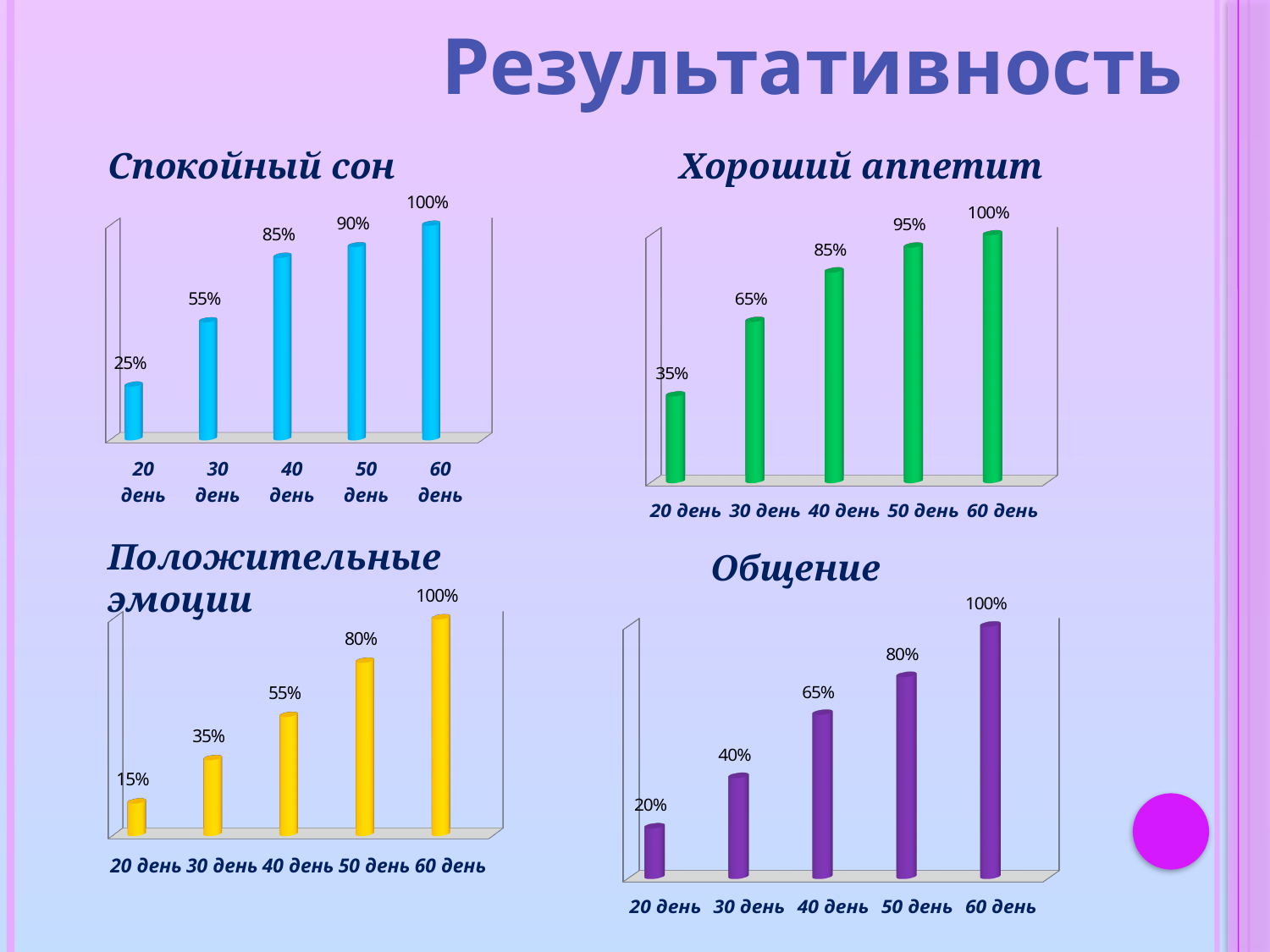
What kind of chart is the 'Положительные эмоции' chart? Bar chart In the 'Хороший аппетит' chart, what is the difference between the values for 60 день and 40 день? 15% In the 'Положительные эмоции' chart, which category has the lowest value? 20 день How many categories are shown in the 'Хороший аппетит' chart? 5 In the 'Спокойный сон' chart, do the values rise or fall from 20 день to 60 день? Rise In the 'Общение' chart, what is the value for 30 день? 40% In the 'Спокойный сон' chart, what is the difference between the values for 30 день and 20 день? 30% In the 'Положительные эмоции' chart, what is the value for 50 день? 80% In the 'Общение' chart, which is larger: the value for 40 день or the value for 50 день? 50 день In the 'Спокойный сон' chart, what is the value for 40 день? 85% In the 'Хороший аппетит' chart, what is the value for 20 день? 35% In the 'Общение' chart, which category has the highest value? 60 день